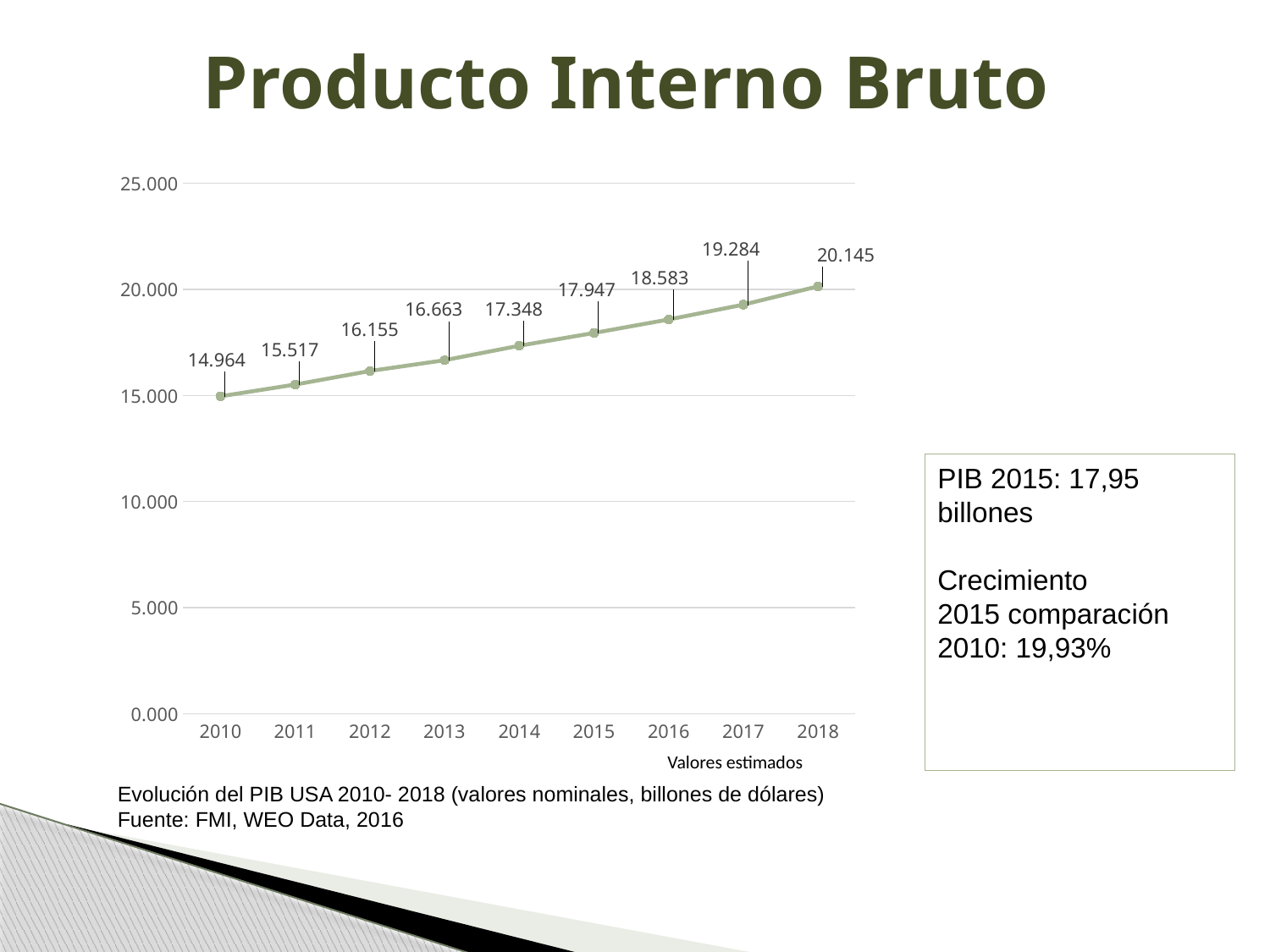
What kind of chart is shown on the slide? line chart What is the value plotted for 2015? 17.947 What is the difference between the values for 2015 and 2014? 0.599 Which year has the highest value on the chart? 2018 What is the difference between the values for 2018 and 2010? 5.181 Is the value for 2017 greater or less than 20.000? less What is the value plotted for 2010? 14.964 Which year has the lowest value on the chart? 2010 Do the values rise or fall from 2010 to 2018? rise What is the value plotted for 2018? 20.145 How many years are plotted on the x axis? 9 Which is larger, the value for 2013 or the value for 2016? 2016